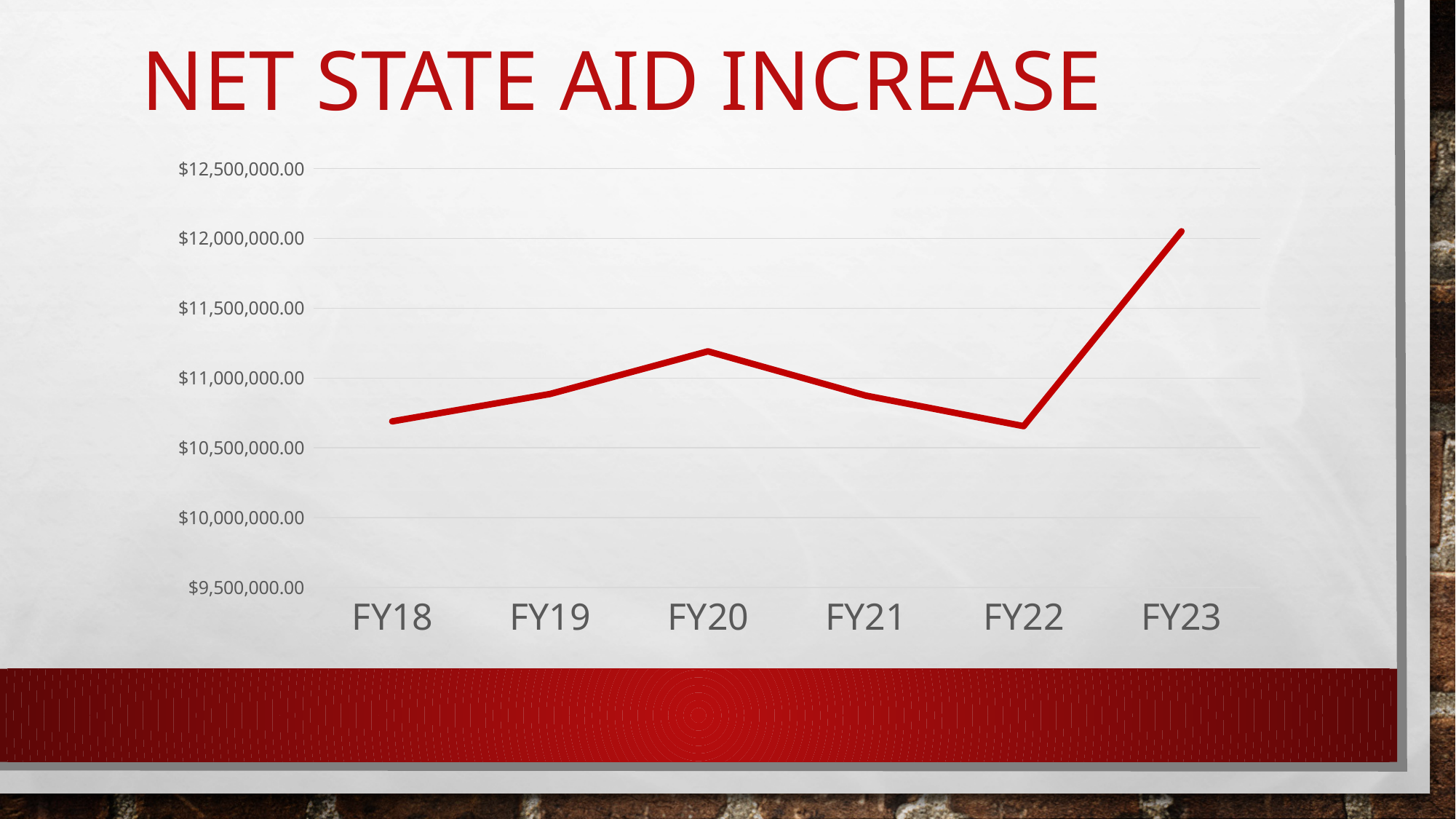
Which fiscal year has the highest net state aid value? FY23 Is the value for FY23 greater or less than $11,500,000.00? greater Is the value for FY20 greater or less than $11,000,000.00? greater Which is larger, the value for FY20 or the value for FY21? FY20 What is the title of the chart? NET STATE AID INCREASE How many fiscal years are plotted on the x axis? 6 Is the value for FY18 greater or less than $10,500,000.00? greater What kind of chart is shown on the slide? line chart Which is larger, the value for FY23 or the value for FY20? FY23 Do the values rise or fall from FY20 to FY22? fall Do the values rise or fall from FY18 to FY20? rise